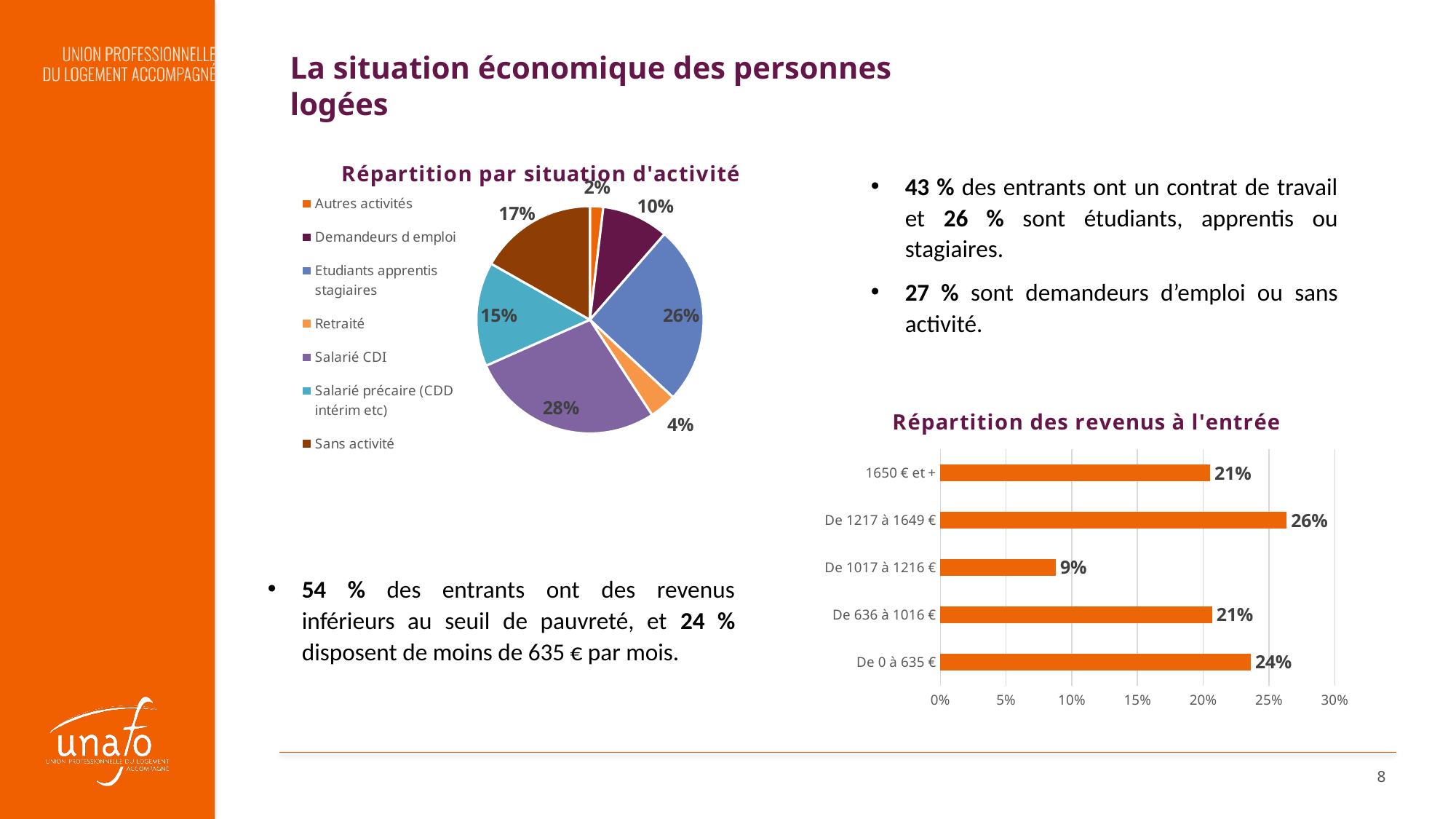
In the 'Répartition des revenus à l'entrée' chart, how many income bands are shown? 5 In the 'Répartition par situation d'activité' chart, how many categories does the legend list? 7 In the 'Répartition par situation d'activité' chart, which category has the smallest share? Autres activités In the 'Répartition des revenus à l'entrée' chart, which income band has the highest value? De 1217 à 1649 € In the 'Répartition par situation d'activité' chart, what share is Sans activité? 17% In the 'Répartition par situation d'activité' chart, what share is Salarié CDI? 28% What kind of chart is 'Répartition des revenus à l'entrée'? Bar chart What kind of chart is 'Répartition par situation d'activité'? Pie chart In the 'Répartition des revenus à l'entrée' chart, what is the value for De 1017 à 1216 €? 9% In the 'Répartition par situation d'activité' chart, which category has the largest share? Salarié CDI In the 'Répartition des revenus à l'entrée' chart, which is larger: De 0 à 635 € or 1650 € et +? De 0 à 635 € In the 'Répartition par situation d'activité' chart, what is the difference between Etudiants apprentis stagiaires and Demandeurs d'emploi? 16%